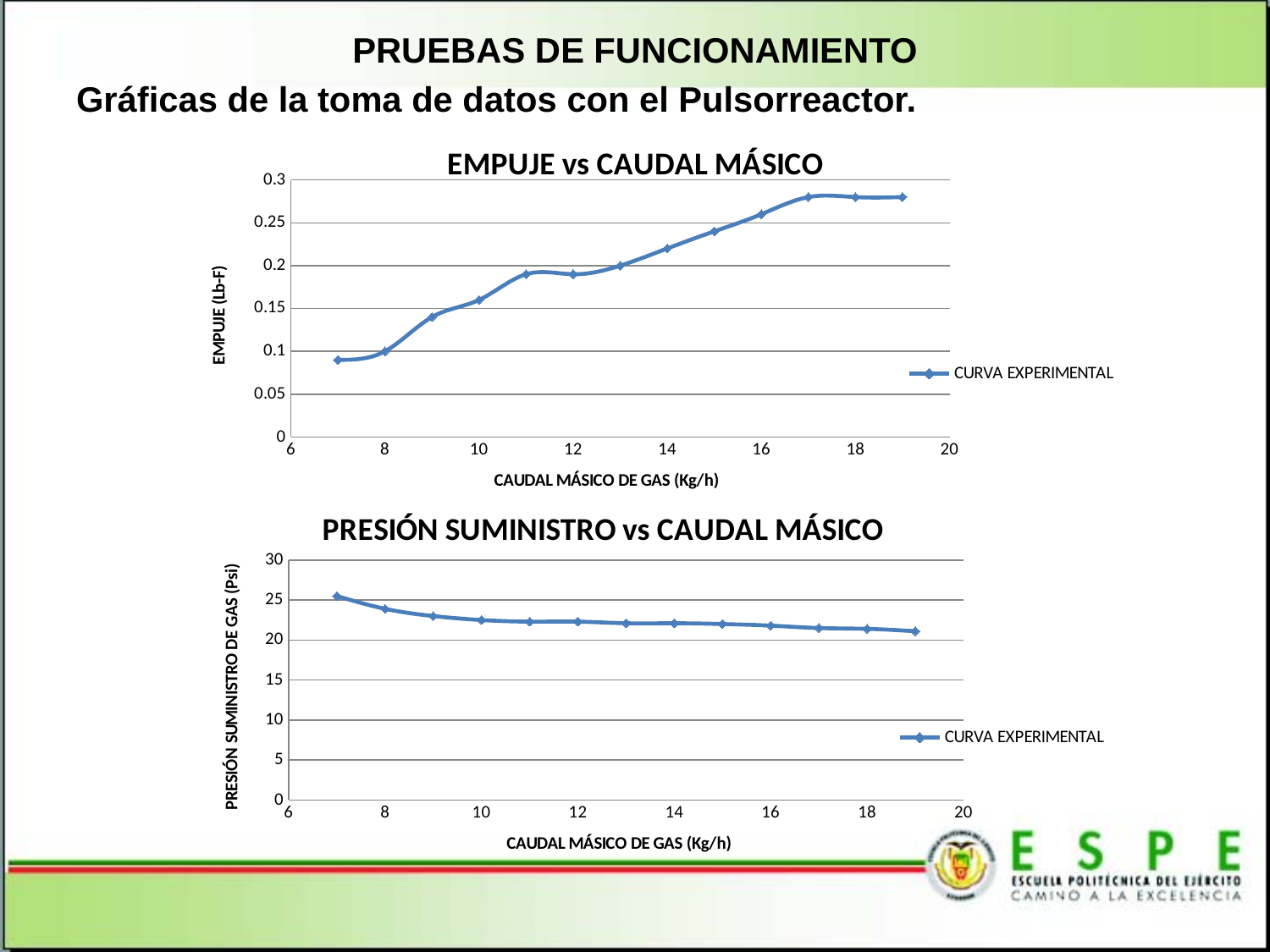
What kind of chart is the EMPUJE vs CAUDAL MÁSICO chart? line chart In the PRESIÓN SUMINISTRO vs CAUDAL MÁSICO chart, at which caudal másico value is the pressure highest? 7 How many series does the legend of the PRESIÓN SUMINISTRO vs CAUDAL MÁSICO chart list? 1 In the EMPUJE vs CAUDAL MÁSICO chart, do the values rise or fall as the caudal másico increases? rise In the EMPUJE vs CAUDAL MÁSICO chart, is the empuje at a caudal másico of 7 greater or less than 0.1? less What is the name of the series shown in the legend of the EMPUJE vs CAUDAL MÁSICO chart? CURVA EXPERIMENTAL In the EMPUJE vs CAUDAL MÁSICO chart, at which caudal másico value is the empuje lowest? 7 In the PRESIÓN SUMINISTRO vs CAUDAL MÁSICO chart, is the pressure at a caudal másico of 12 greater or less than 25? less How many data points are plotted in the EMPUJE vs CAUDAL MÁSICO chart? 13 In the PRESIÓN SUMINISTRO vs CAUDAL MÁSICO chart, do the values rise or fall as the caudal másico increases? fall What kind of chart is the PRESIÓN SUMINISTRO vs CAUDAL MÁSICO chart? line chart In the EMPUJE vs CAUDAL MÁSICO chart, is the empuje at a caudal másico of 19 greater or less than 0.25? greater